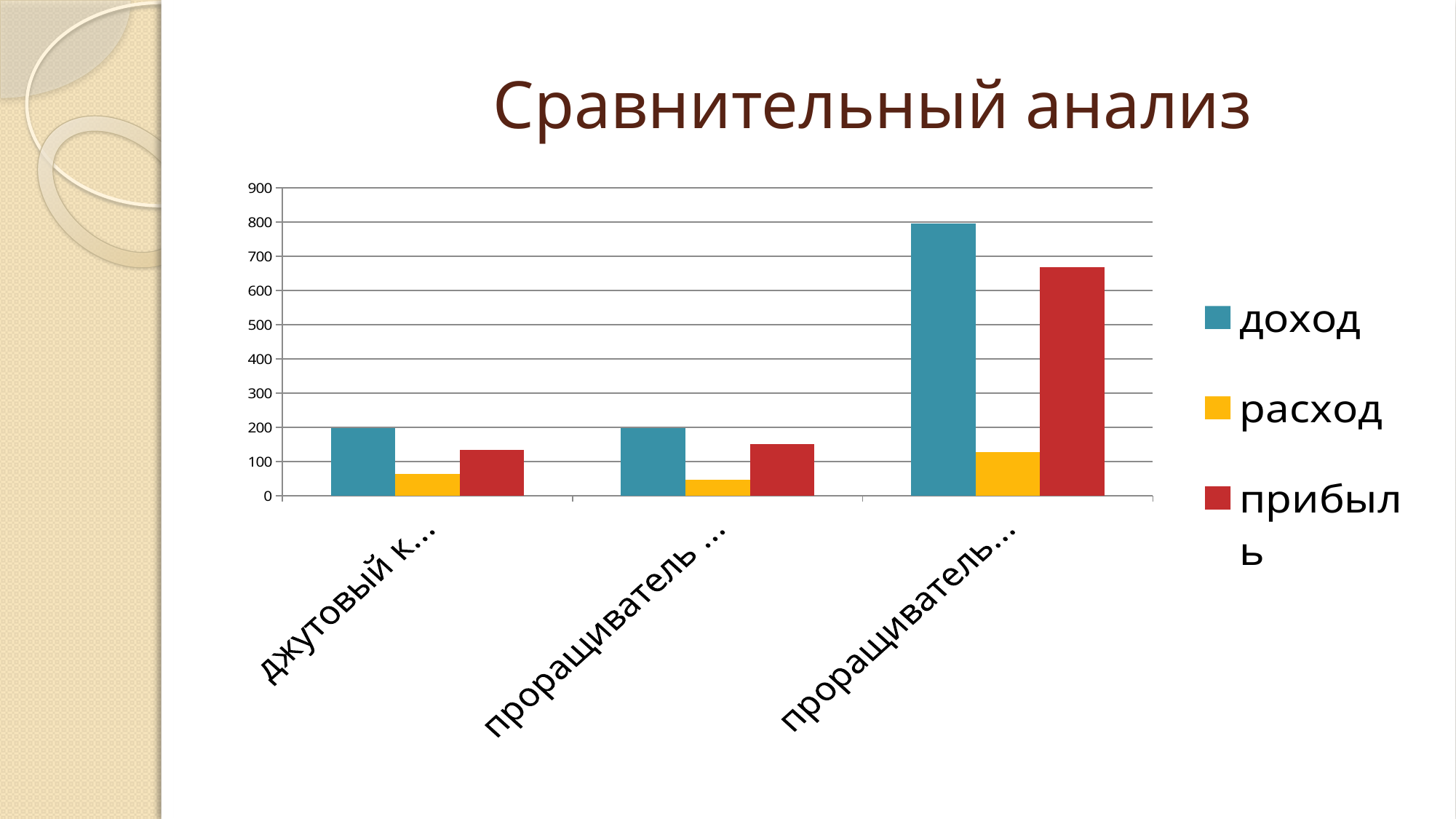
Is the value for 'прибыль' in the third category greater or less than 600? greater Which series has the lowest value in the third category? расход Is the value for 'расход' in the first category greater or less than 100? less How many categories are shown on the x axis? 3 How many series does the legend list? 3 In the third category, which is larger: 'доход' or 'прибыль'? доход What is the title of the slide? Сравнительный анализ Which category has the highest value for 'доход'? the third category Is the value for 'доход' in the third category greater or less than 700? greater What kind of chart is shown on the slide? bar chart Which colour represents the series 'прибыль' in the legend? red